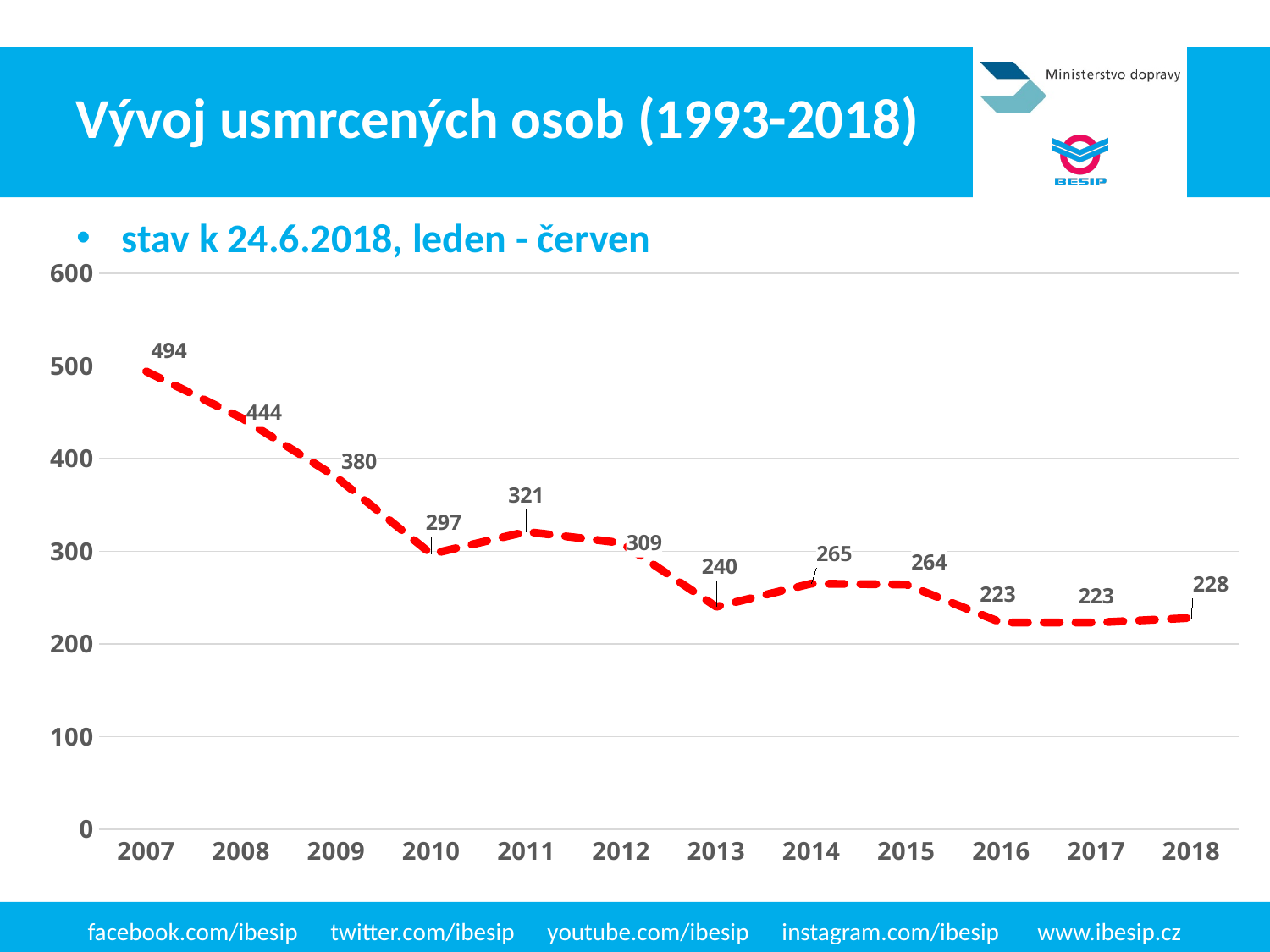
What is the value for 2013? 240 What is the difference between the values for 2007 and 2018? 266 Which year has the highest value? 2007 Which years share the lowest value? 2016 and 2017 How many years are plotted on the x axis? 12 What kind of chart is shown on the slide? line chart Do the values generally rise or fall from 2007 to 2018? fall Is the value for 2009 greater or less than 400? less Which is larger, the value for 2014 or the value for 2015? 2014 What is the value for 2018? 228 What is the difference between the values for 2011 and 2012? 12 What is the value for 2007? 494